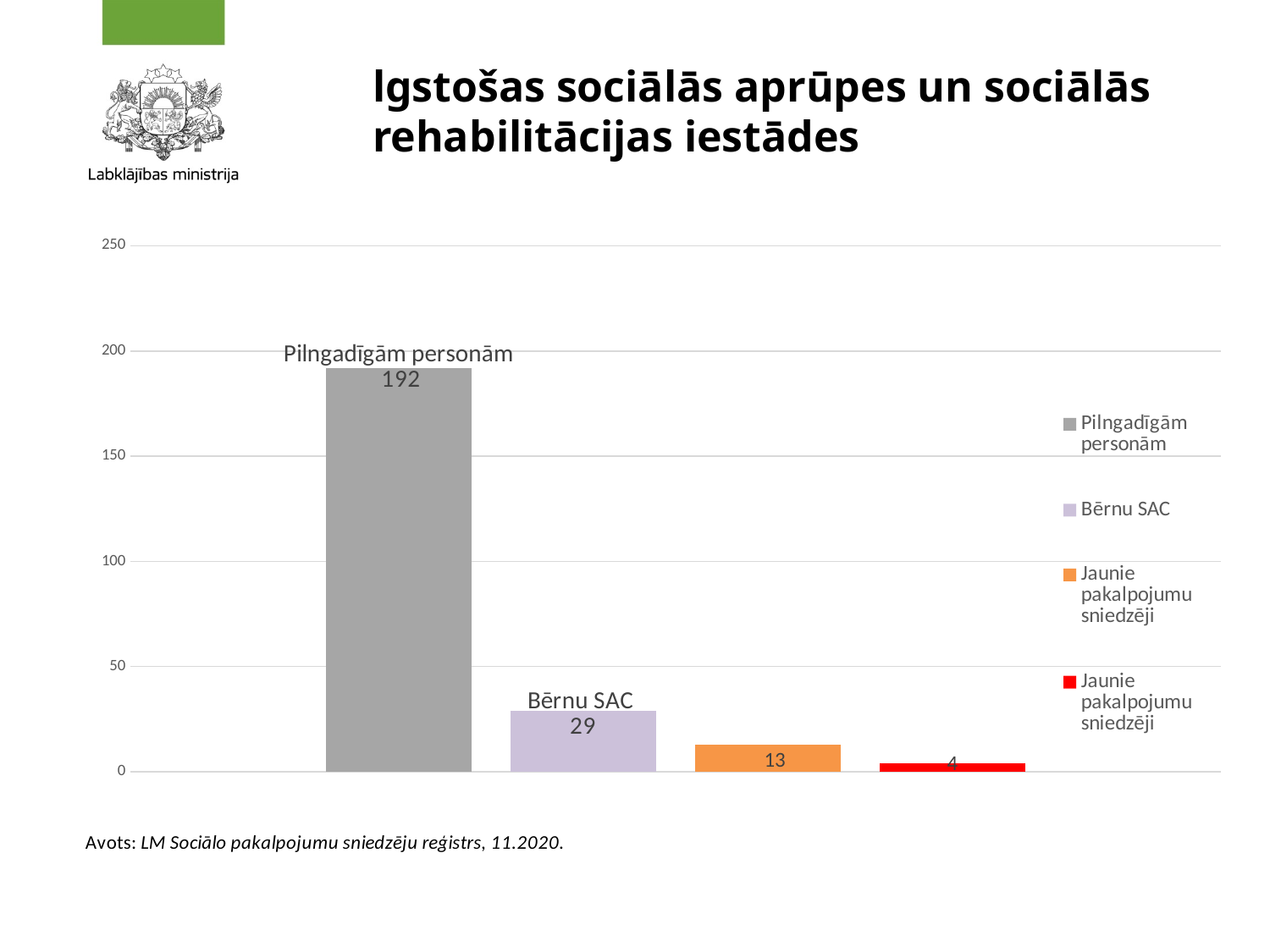
How many entries does the legend list? 4 What is the difference between the values for Pilngadīgām personām and Bērnu SAC? 163 Which is larger, the value for Bērnu SAC or the orange bar? Bērnu SAC What is the value of the orange bar (Jaunie pakalpojumu sniedzēji)? 13 What is the value for Bērnu SAC? 29 What kind of chart is shown on the slide? bar chart How many bars are plotted in the chart? 4 Which category has the highest value? Pilngadīgām personām What is the difference between the orange bar and the red bar? 9 What is the value of the red bar (Jaunie pakalpojumu sniedzēji)? 4 What is the value for Pilngadīgām personām? 192 Is the value for Pilngadīgām personām greater or less than 150? greater